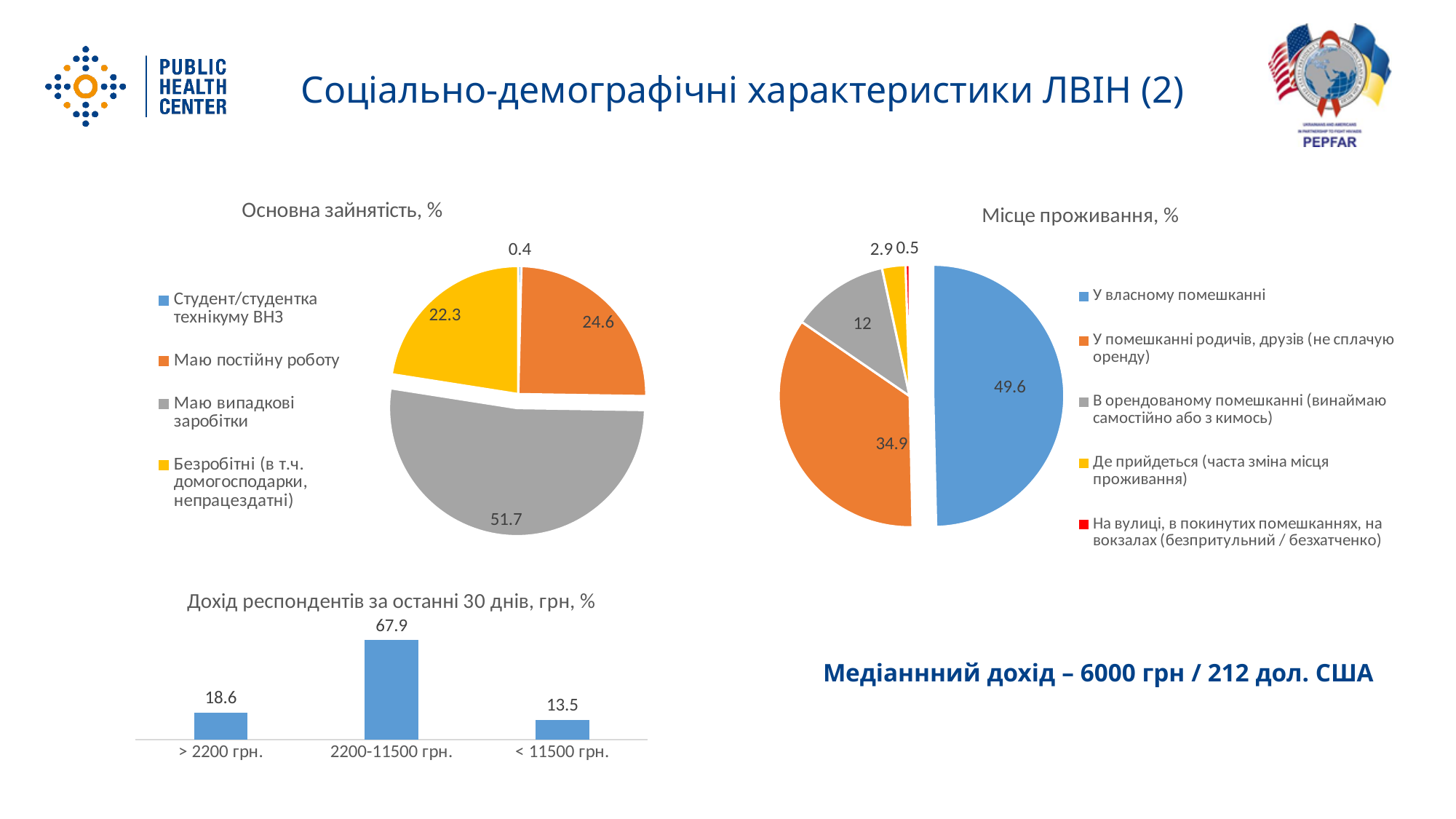
In the chart 'Основна зайнятість, %', what is the value for 'Маю випадкові заробітки'? 51.7 In the chart 'Дохід респондентів за останні 30 днів, грн, %', which category has the lowest value? < 11500 грн. In the chart 'Дохід респондентів за останні 30 днів, грн, %', what is the difference between '> 2200 грн.' and '< 11500 грн.'? 5.1 In the chart 'Основна зайнятість, %', what is the difference between 'Маю постійну роботу' and 'Безробітні (в т.ч. домогосподарки, непрацездатні)'? 2.3 In the chart 'Основна зайнятість, %', how many categories does the legend list? 4 In the chart 'Місце проживання, %', how many categories does the legend list? 5 In the chart 'Основна зайнятість, %', which category has the smallest share? Студент/студентка технікуму ВНЗ What kind of chart is 'Дохід респондентів за останні 30 днів, грн, %'? bar chart In the chart 'Дохід респондентів за останні 30 днів, грн, %', what is the value for '2200-11500 грн.'? 67.9 In the chart 'Місце проживання, %', which is larger: 'В орендованому помешканні (винаймаю самостійно або з кимось)' or 'Де прийдеться (часта зміна місця проживання)'? В орендованому помешканні (винаймаю самостійно або з кимось) In the chart 'Місце проживання, %', which category has the largest share? У власному помешканні In the chart 'Місце проживання, %', what is the value for 'У помешканні родичів, друзів (не сплачую оренду)'? 34.9